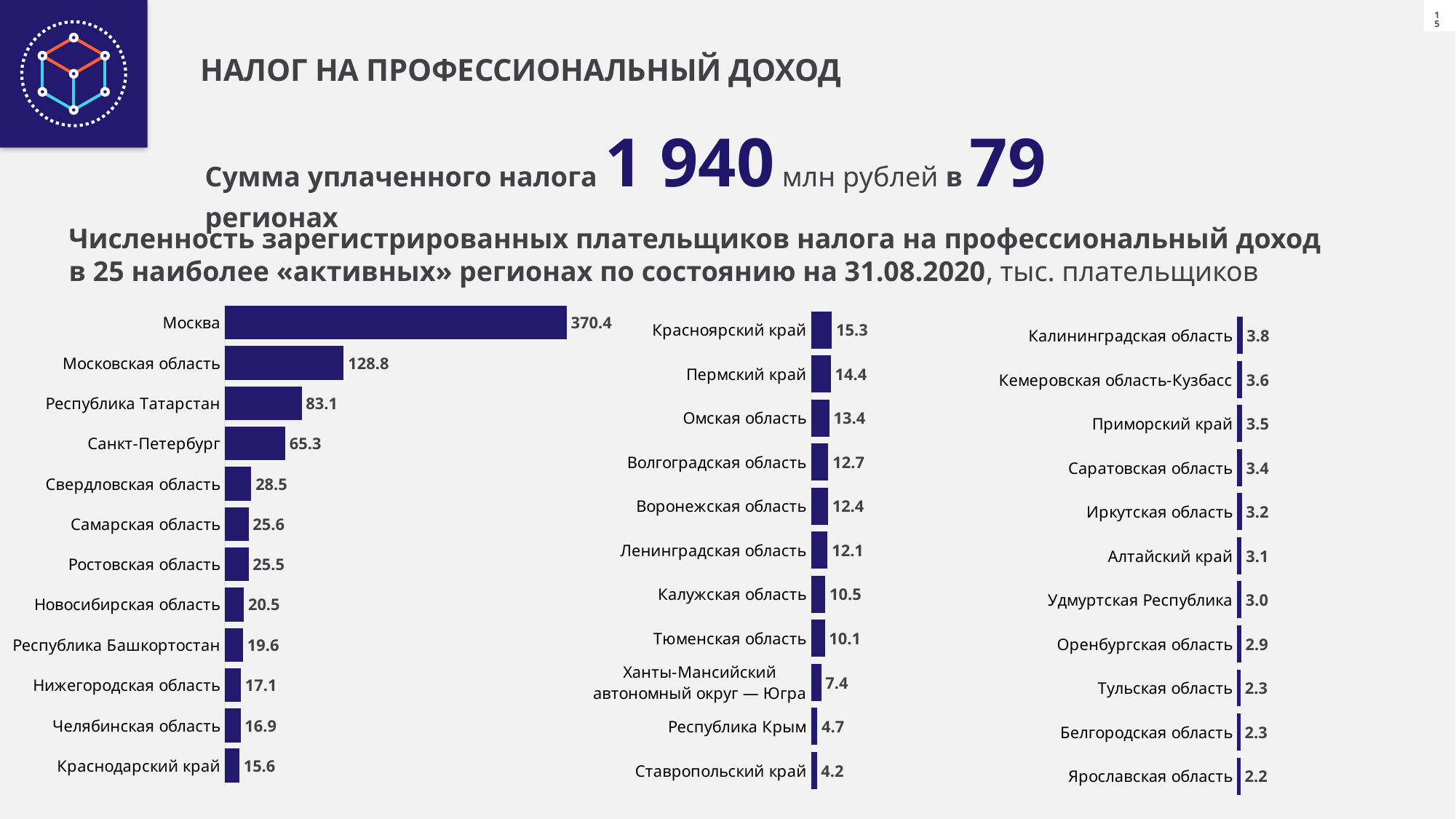
In the middle chart, which is larger: the value for Красноярский край or the value for Пермский край? Красноярский край In the middle chart, what is the value for Ленинградская область? 12.1 In the right chart, what is the value for Удмуртская Республика? 3.0 How many regions are shown in the middle chart? 11 How many regions are shown in the left chart? 12 In the right chart, which region has the highest value? Калининградская область In the left chart, which region has the highest value? Москва In the left chart, what is the difference between the values for Москва and Московская область? 241.6 What kind of chart is the left chart? Bar chart In the middle chart, which region has the lowest value? Ставропольский край In the left chart, what is the value for Республика Татарстан? 83.1 In the left chart, what is the value for Москва? 370.4